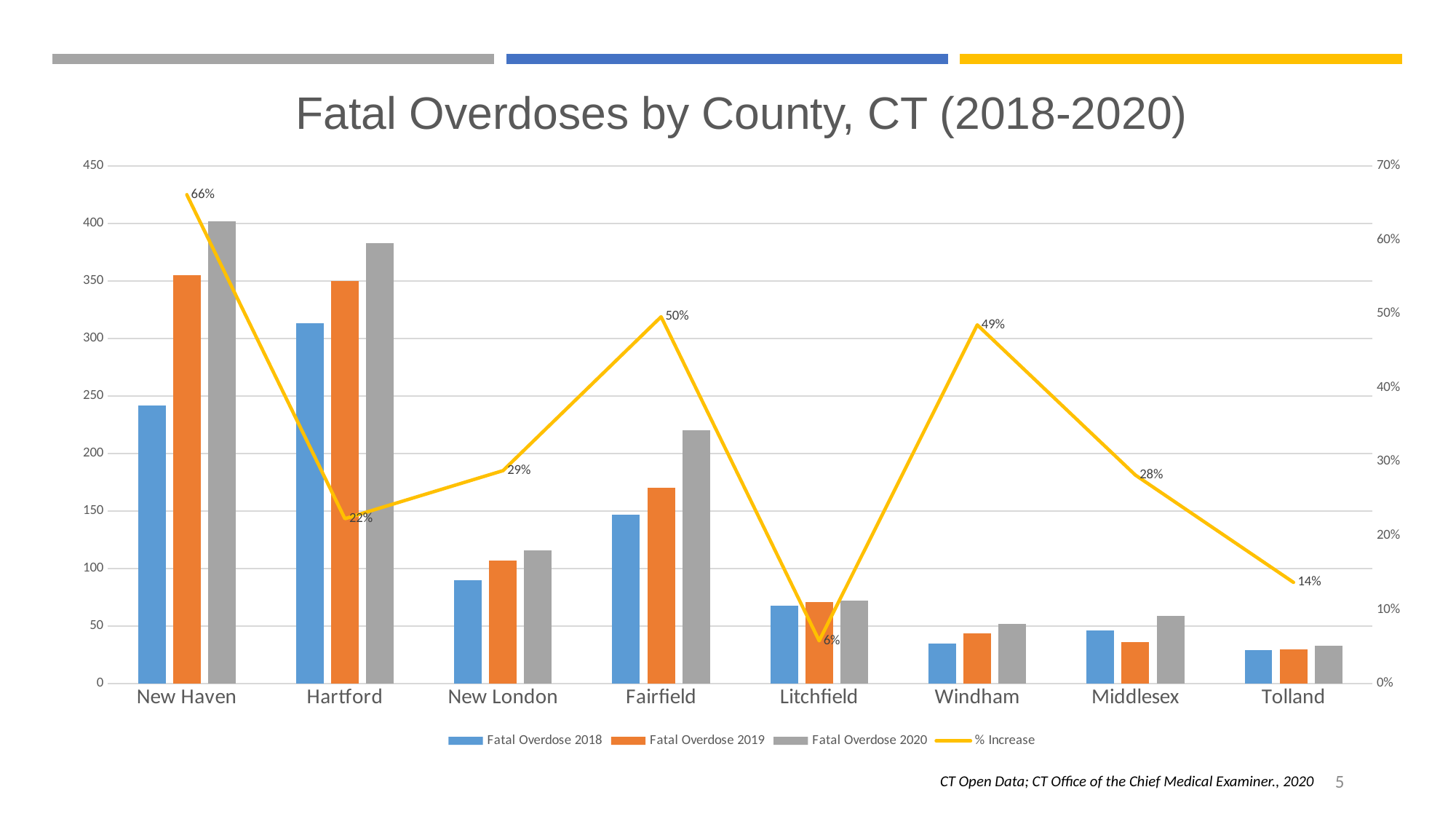
What is the title of the chart? Fatal Overdoses by County, CT (2018-2020) Is the Fatal Overdose 2018 value for Hartford greater or less than 300? greater What is the % Increase value shown for Fairfield? 50% Which county has the lowest % Increase? Litchfield What is the % Increase value shown for Litchfield? 6% How many series does the legend list? 4 How many counties are shown on the x axis? 8 Is the Fatal Overdose 2020 value for Tolland greater or less than 50? less What is the difference between the % Increase for New Haven and the % Increase for Tolland? 52% Which county has the highest % Increase? New Haven Which has a larger % Increase, Windham or Middlesex? Windham What is the % Increase value shown for New Haven? 66%